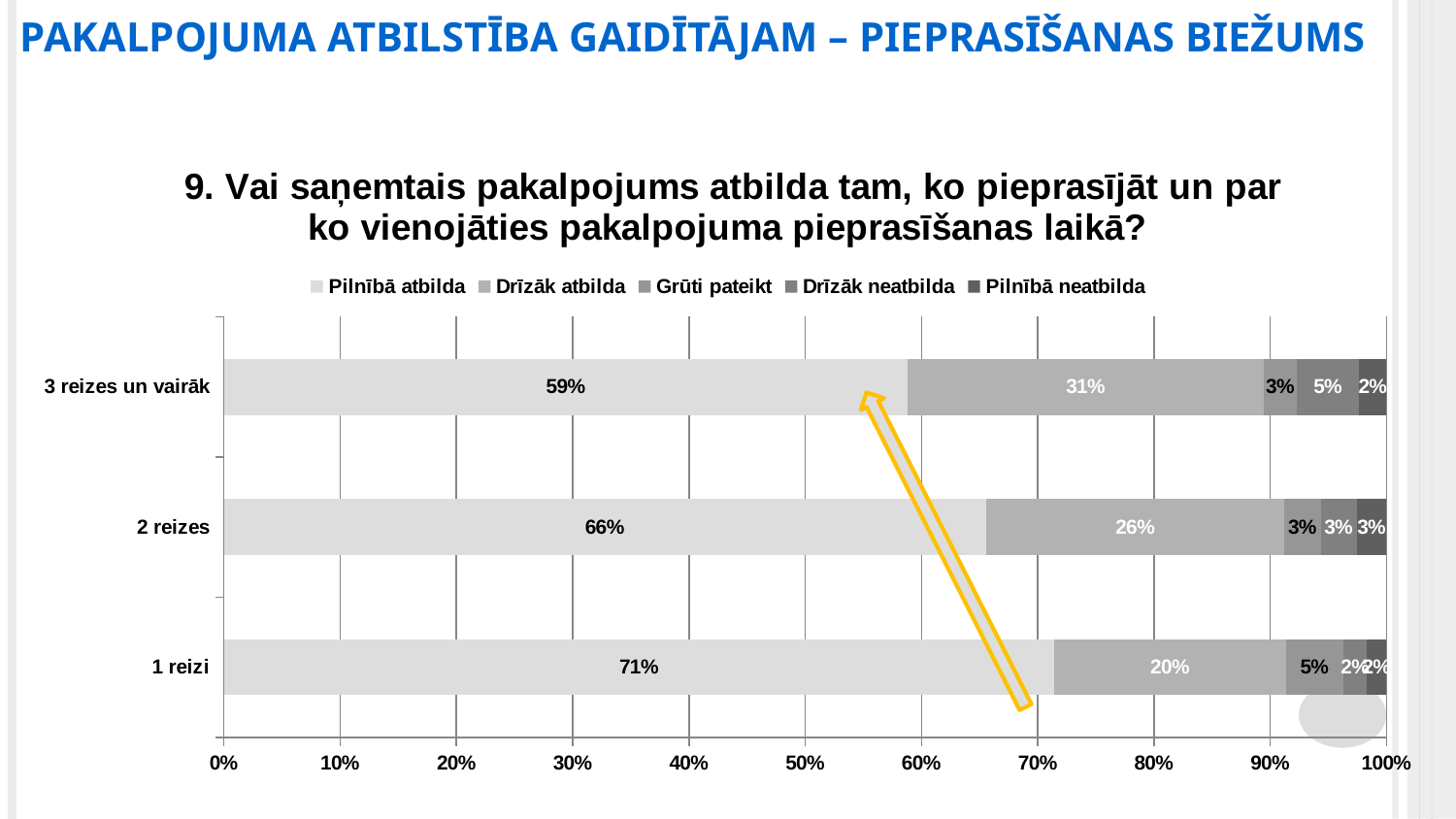
Which category has the lowest value for "Drīzāk atbilda"? 1 reizi Which is larger: "Drīzāk atbilda" for "2 reizes" or "Drīzāk atbilda" for "1 reizi"? 2 reizes Which category has the highest value for "Pilnībā atbilda"? 1 reizi How many series does the legend list? 5 How many categories are shown on the vertical axis? 3 What is the value of "Drīzāk neatbilda" for "3 reizes un vairāk"? 5% Which legend entry is listed first? Pilnībā atbilda What is the value of "Pilnībā atbilda" for "2 reizes"? 66% What is the difference between the "Pilnībā atbilda" values for "1 reizi" and "3 reizes un vairāk"? 12% What is the value of "Drīzāk atbilda" for "3 reizes un vairāk"? 31% What kind of chart is shown on the slide? stacked bar chart What is the value of "Pilnībā atbilda" for "1 reizi"? 71%